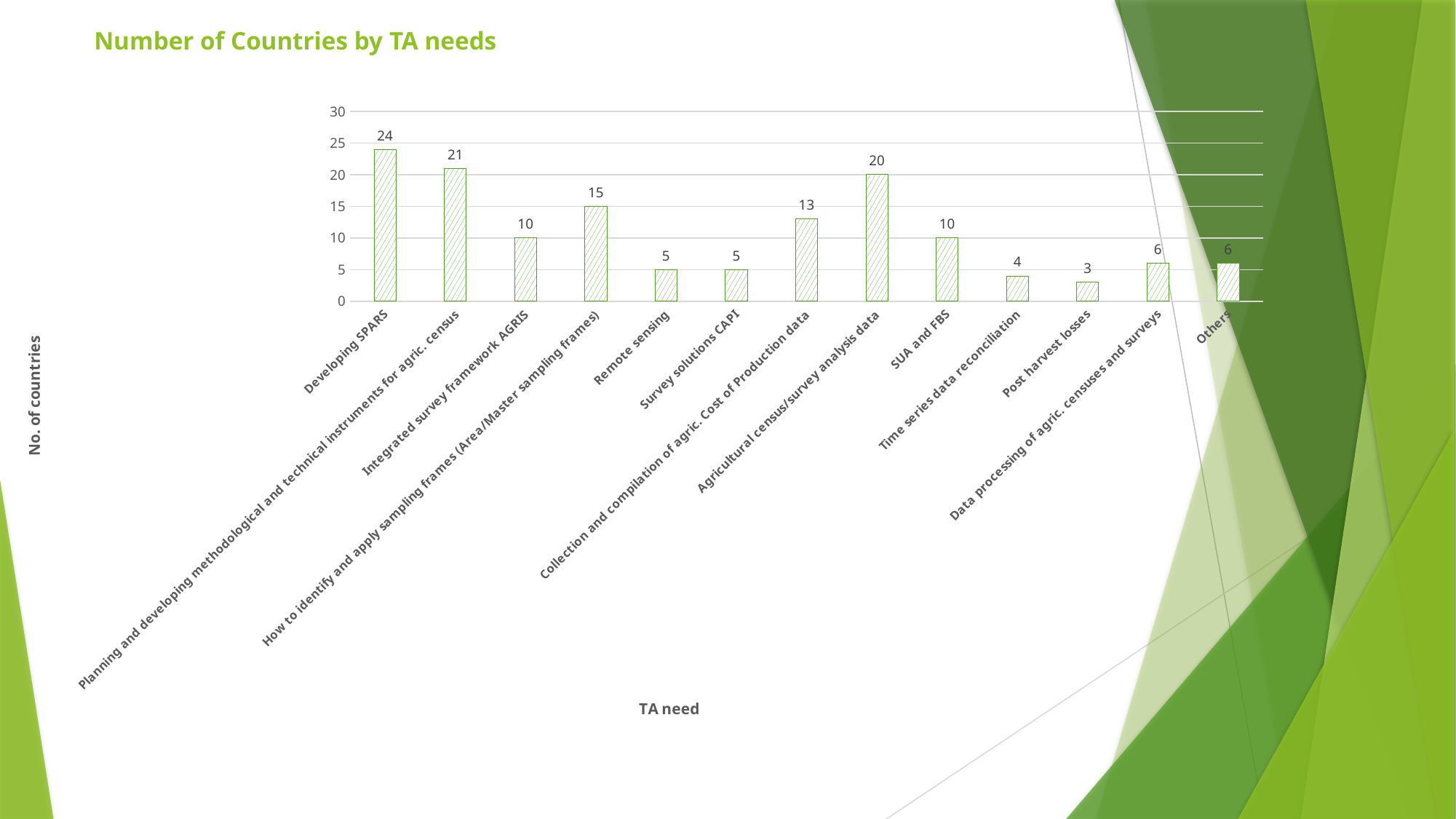
What is the number of countries for Developing SPARS? 24 What is the label of the vertical axis? No. of countries What is the number of countries for Agricultural census/survey analysis data? 20 Which TA need has the highest number of countries? Developing SPARS What is the number of countries for Post harvest losses? 3 What is the number of countries for Collection and compilation of agric. Cost of Production data? 13 What is the difference in number of countries between Developing SPARS and Planning and developing methodological and technical instruments for agric. census? 3 Which TA need has the lowest number of countries? Post harvest losses What is the title of the chart? Number of Countries by TA needs How many TA need categories are shown in the chart? 13 Which has more countries: Integrated survey framework AGRIS or How to identify and apply sampling frames (Area/Master sampling frames)? How to identify and apply sampling frames (Area/Master sampling frames) What kind of chart is shown on the slide? Bar chart